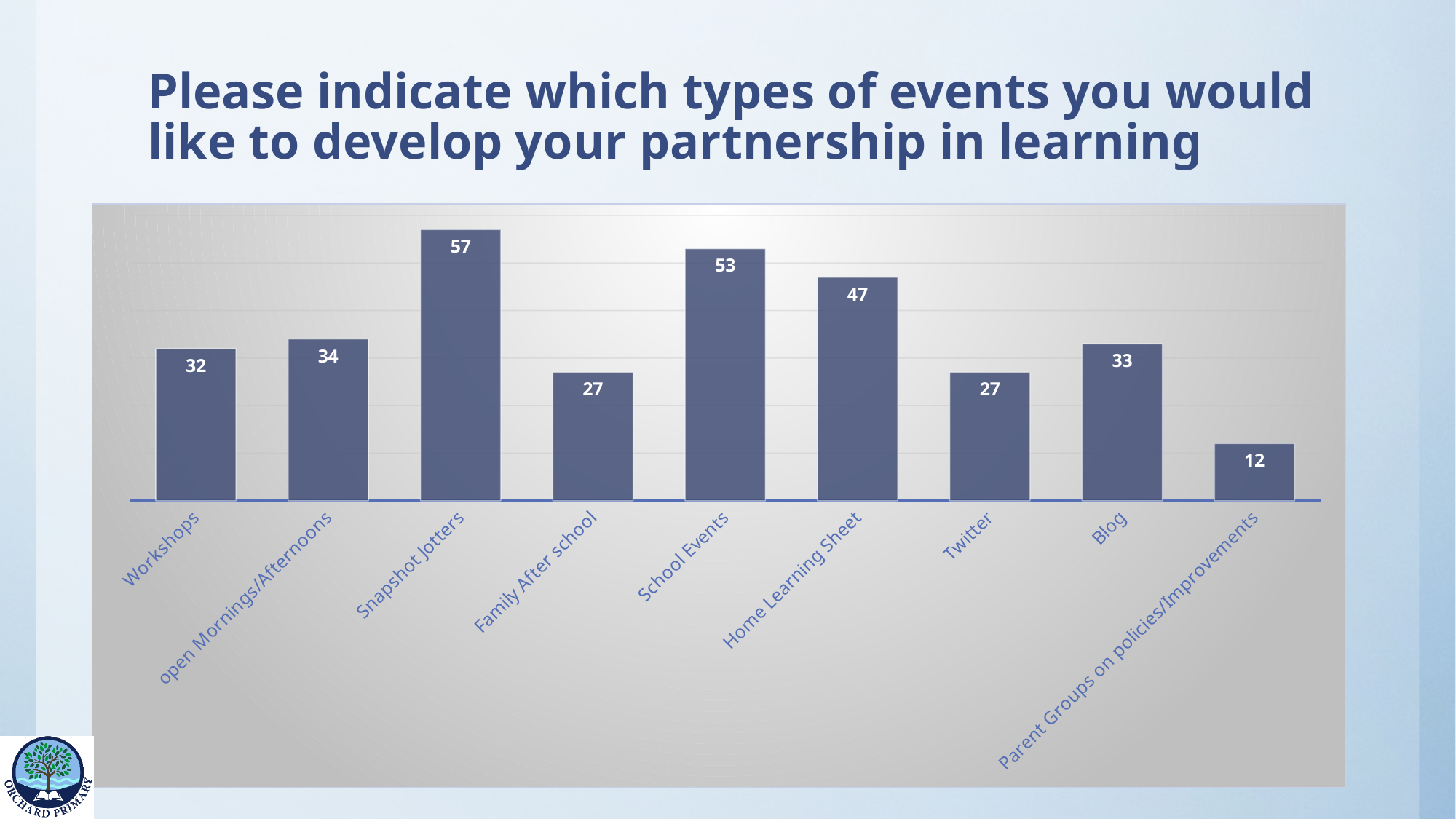
What is the difference between the values for Home Learning Sheet and Twitter? 20 Which is larger, the value for Workshops or the value for open Mornings/Afternoons? open Mornings/Afternoons What is the difference between the values for Snapshot Jotters and School Events? 4 What is the value for Parent Groups on policies/Improvements? 12 Which category has the lowest value? Parent Groups on policies/Improvements Which category has the highest value? Snapshot Jotters What is the title of the slide? Please indicate which types of events you would like to develop your partnership in learning What is the value for Snapshot Jotters? 57 What is the value for Home Learning Sheet? 47 What kind of chart is shown on the slide? Bar chart How many categories are shown in the chart? 9 What is the value for Blog? 33